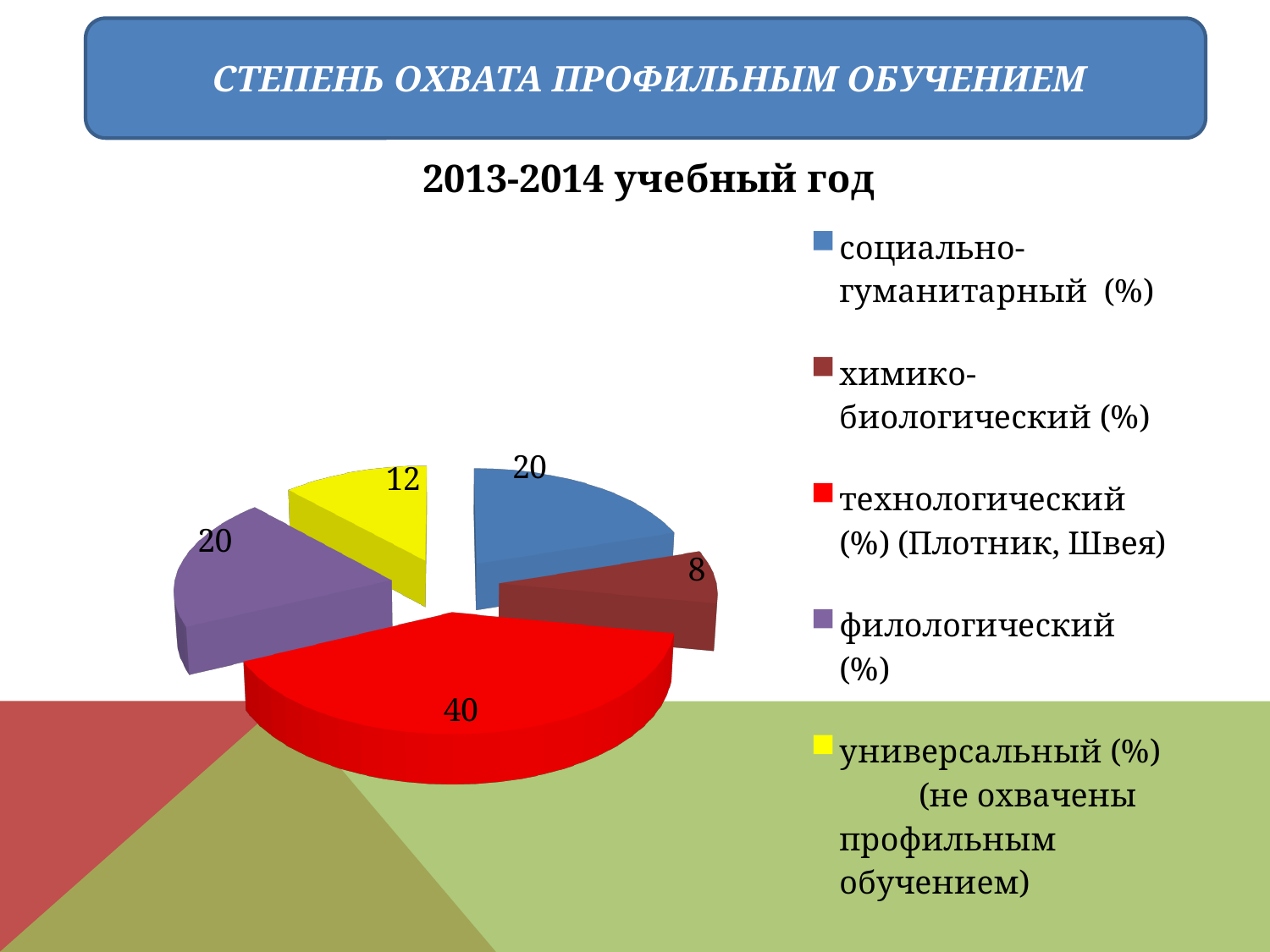
What is the title of the chart? 2013-2014 учебный год Which category has the smallest slice of the pie? химико-биологический (%) How many categories does the legend list? 5 Which is larger, the value for универсальный (%) or the value for химико-биологический (%)? универсальный (%) What type of chart is shown on the slide? pie chart What is the value for универсальный (%)? 12 What is the value for химико-биологический (%)? 8 What share of the pie does the технологический (%) slice represent? 40% What is the value for социально-гуманитарный (%)? 20 What is the value for технологический (%) (Плотник, Швея)? 40 What is the difference between the values for технологический (%) and филологический (%)? 20 Which category has the largest slice of the pie? технологический (%) (Плотник, Швея)